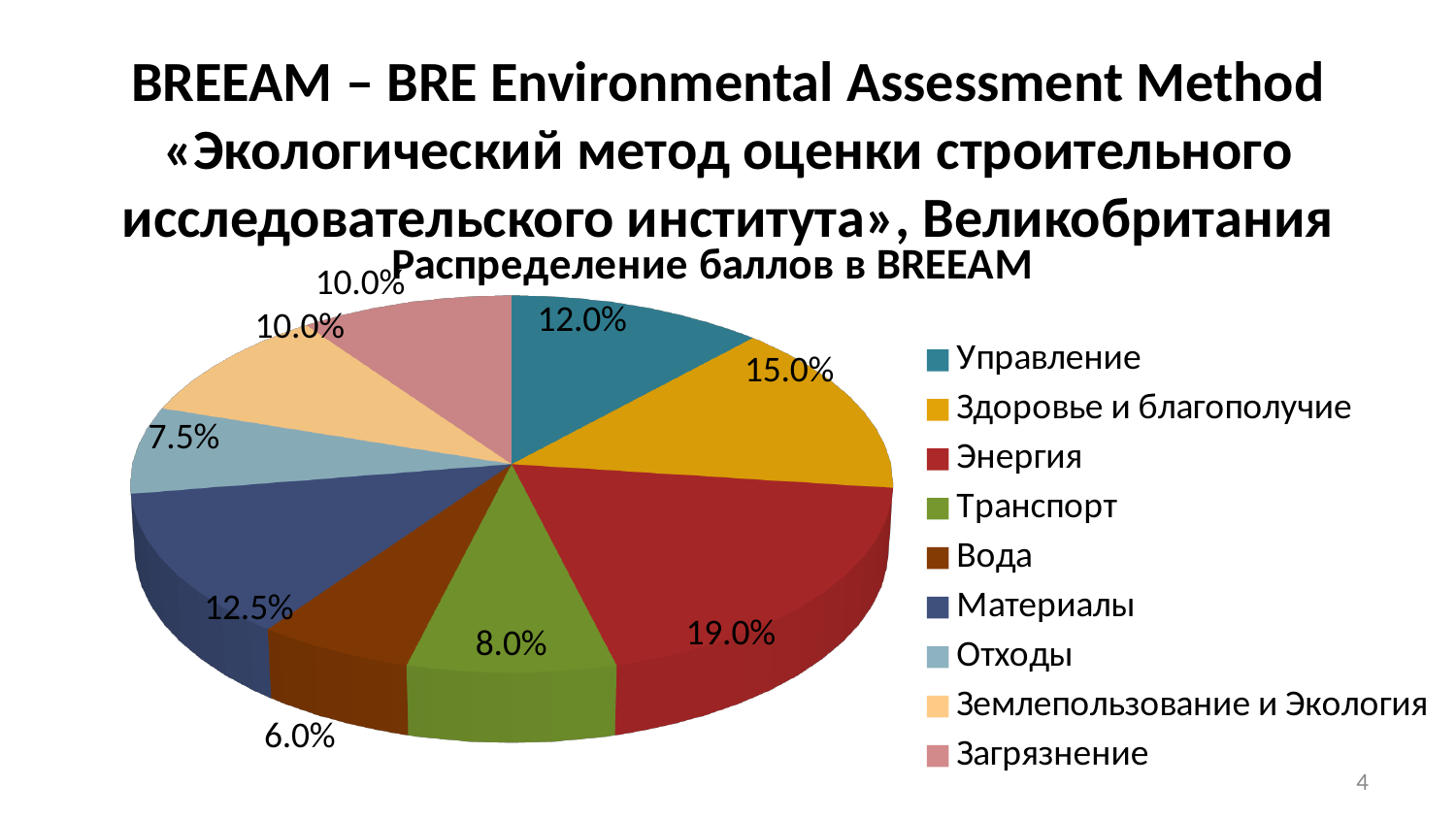
Which category has the smallest share of the pie? Вода What is the value for Вода? 6.0% Which category has the largest share of the pie? Энергия What kind of chart is shown on the slide? pie chart Which is larger, the share for Управление or the share for Отходы? Управление What colour is the slice for Загрязнение? pink What is the value for Материалы? 12.5% What is the value for Здоровье и благополучие? 15.0% What is the difference between the shares of Энергия and Транспорт? 11.0% How many categories does the legend list? 9 What share of the pie does Энергия have? 19.0% What is the title of the chart? Распределение баллов в BREEAM